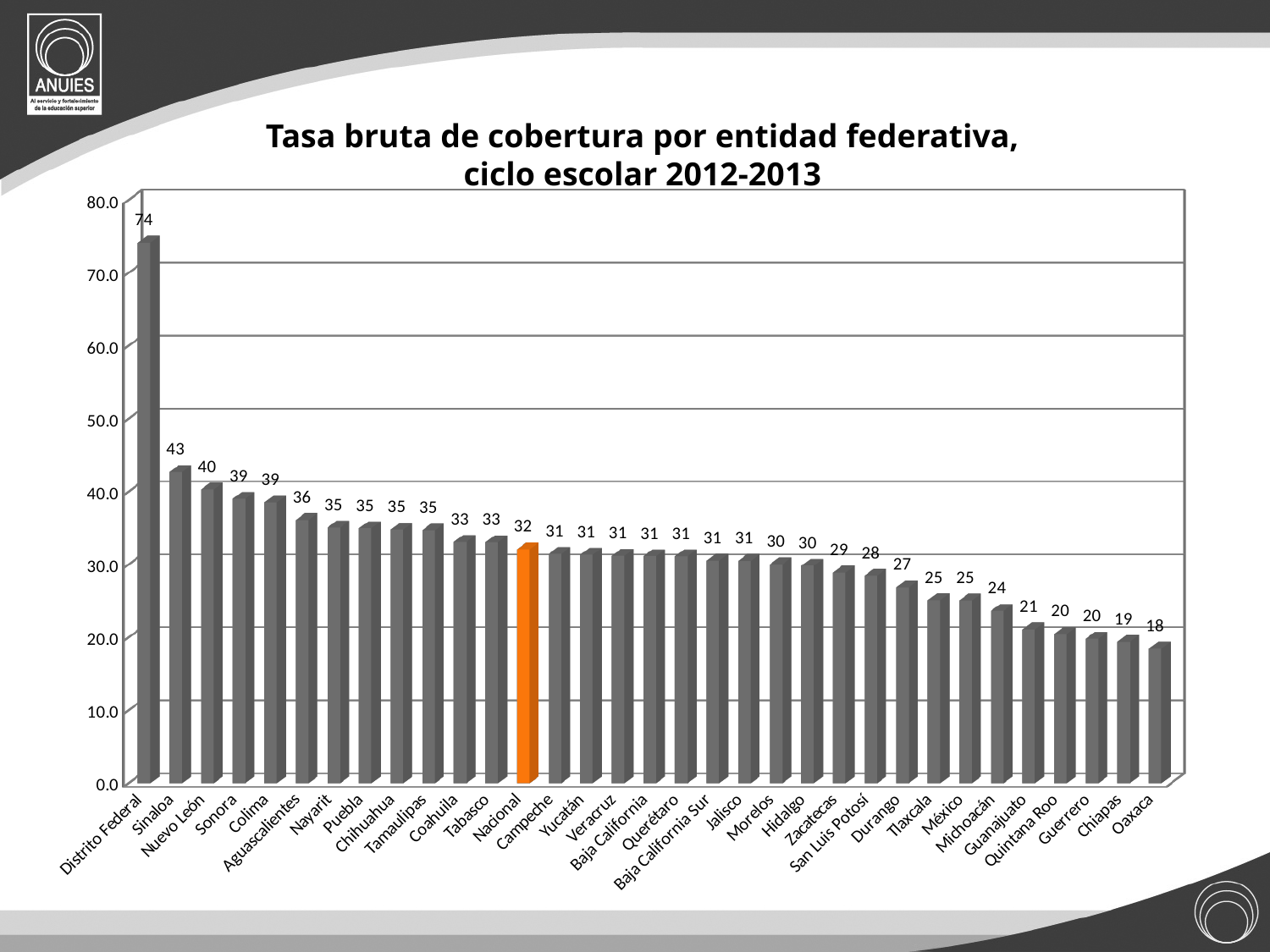
What is the value for Nacional? 32 What is the value for Sinaloa? 43 What is the difference between the values for Distrito Federal and Sinaloa? 31 Which has a larger value, Nuevo León or Michoacán? Nuevo León What is the value for Oaxaca? 18 What is the value for Distrito Federal? 74 Which bar is highlighted in orange? Nacional Which entity has the highest value? Distrito Federal Is the value for Durango greater or less than 30.0? less What kind of chart is shown on the slide? bar chart Which entity has the lowest value? Oaxaca How many bars are shown in the chart? 33